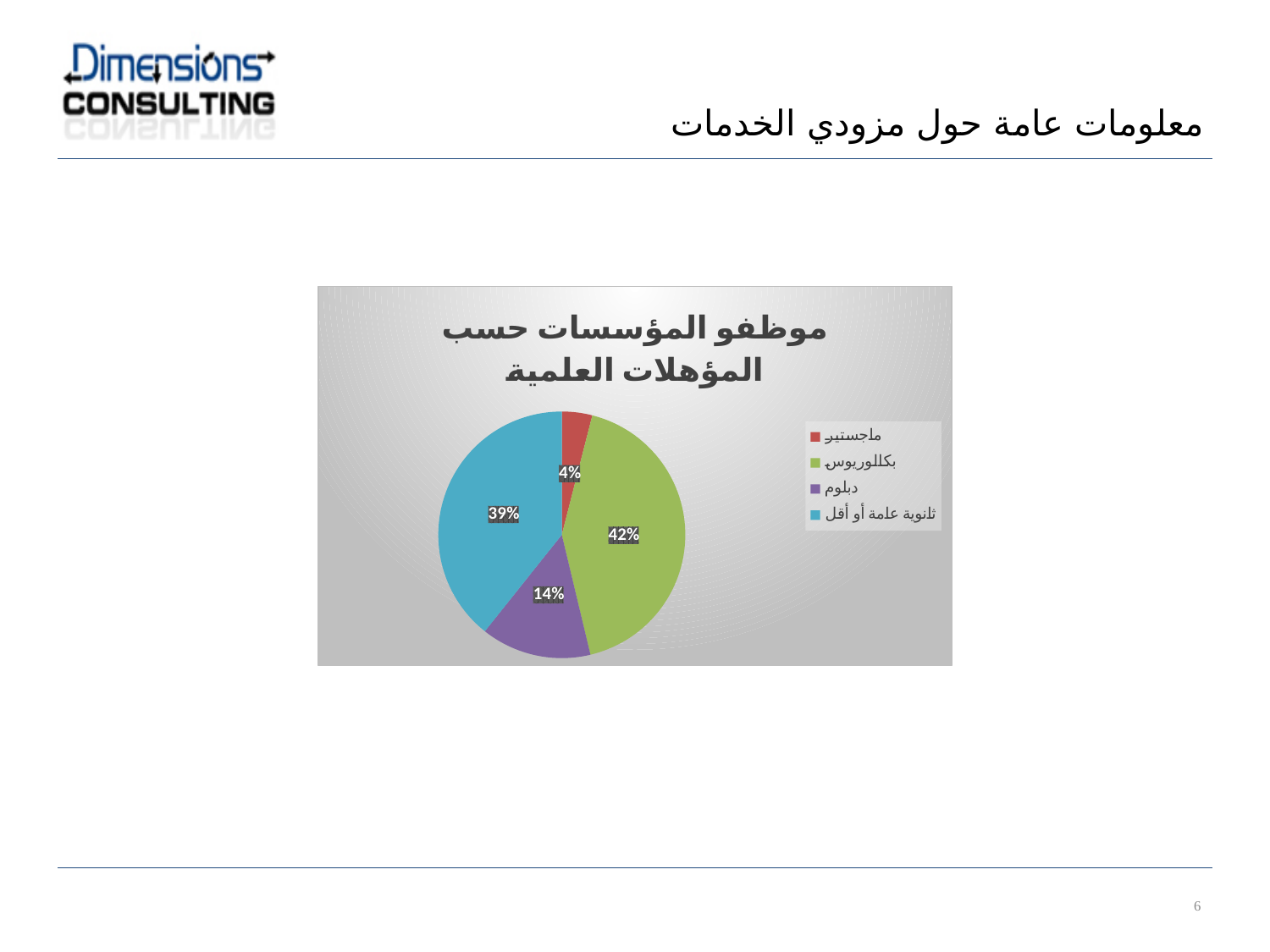
What colour is the slice for ثانوية عامة أو أقل? Blue Which qualification category has the largest share of employees? بكالوريوس What kind of chart is shown on the slide? Pie chart What is the difference in percentage points between the بكالوريوس share and the دبلوم share? 28 What percentage of employees hold a بكالوريوس (bachelor's degree)? 42% What is the title of the chart? موظفو المؤسسات حسب المؤهلات العلمية What percentage of employees hold a دبلوم (diploma)? 14% What percentage of employees hold a ماجستير (master's degree)? 4% Which qualification category has the smallest share of employees? ماجستير How many qualification categories does the pie chart show? 4 What percentage of employees have ثانوية عامة أو أقل (high school or less)? 39% Which is larger, the share for دبلوم or the share for ثانوية عامة أو أقل? ثانوية عامة أو أقل